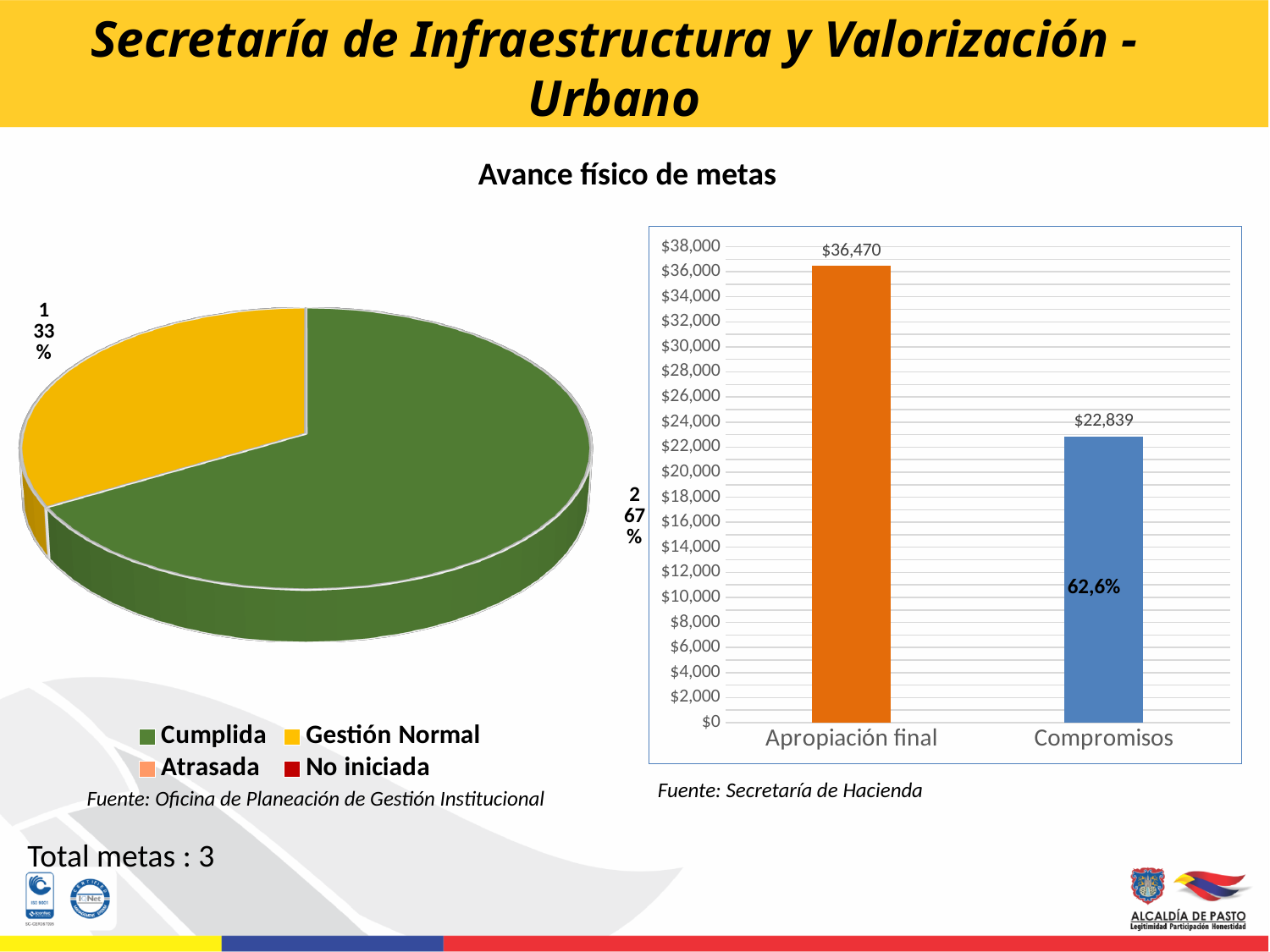
What kind of chart is shown on the right side of the slide? Bar chart On the pie chart on the left, what share does the Cumplida slice represent? 67% On the pie chart on the left, what share does the Gestión Normal slice represent? 33% On the bar chart on the right, what is the value for Apropiación final? $36,470 On the bar chart on the right, what percentage label is shown on the Compromisos bar? 62,6% On the pie chart on the left, how many entries does the legend list? 4 On the bar chart on the right, what is the difference between Apropiación final and Compromisos? $13,631 On the bar chart on the right, is the value for Compromisos greater or less than $20,000? greater On the bar chart on the right, how many categories are shown on the x axis? 2 On the bar chart on the right, what is the value for Compromisos? $22,839 On the pie chart on the left, which legend entry is shown in green? Cumplida On the bar chart on the right, which category has the higher value? Apropiación final